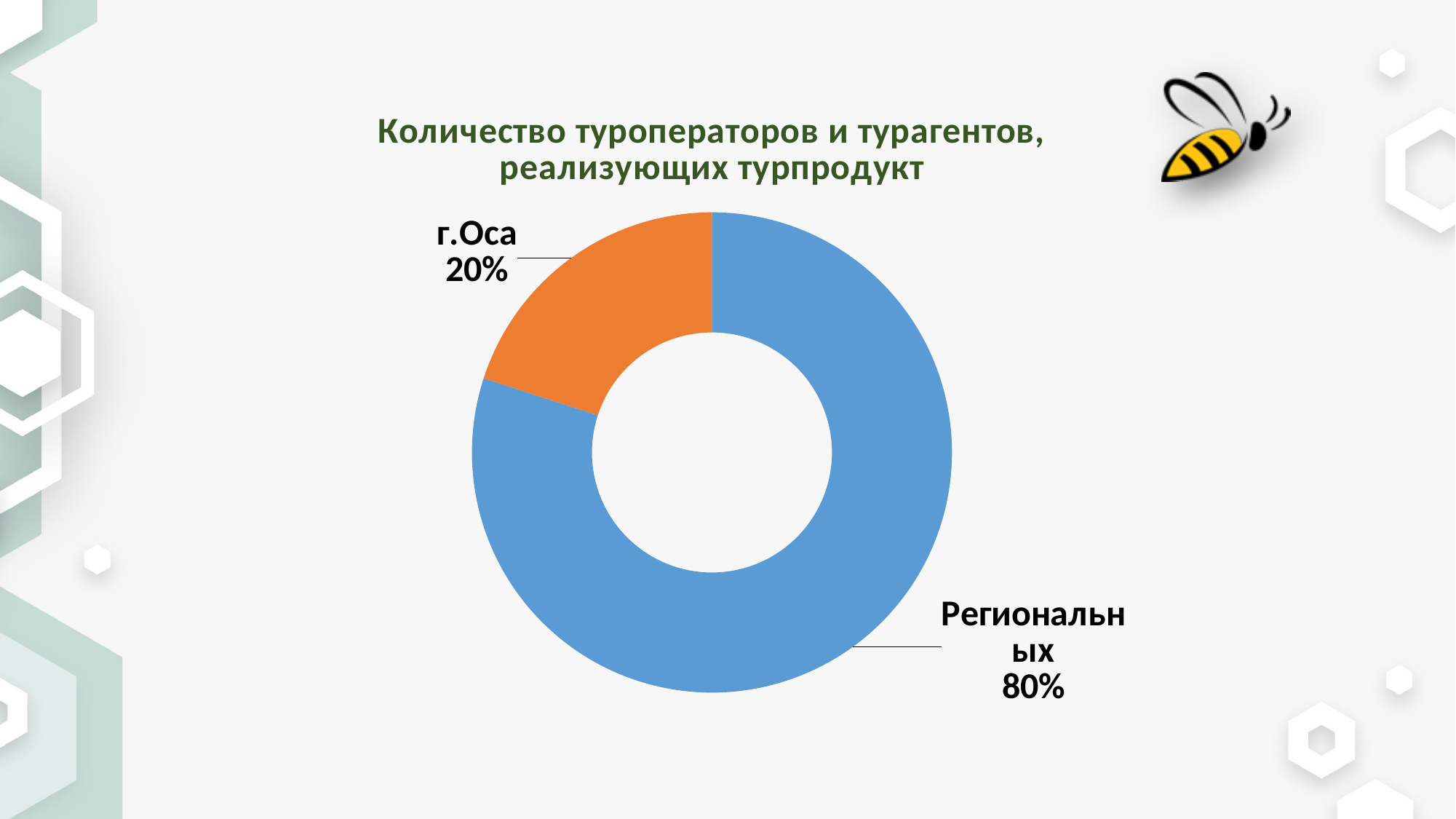
What is the title of the chart? Количество туроператоров и турагентов, реализующих турпродукт What is the difference in percentage points between the "Региональных" and "г.Оса" shares? 60 percentage points What share of the chart does the "Региональных" slice represent? 80% What colour is the "г.Оса" slice? Orange What kind of chart is shown on the slide? Doughnut (pie) chart Which category has the smallest share? г.Оса What share of the chart does the "г.Оса" slice represent? 20% How many categories are shown in the chart? 2 Which is larger, the share for "г.Оса" or the share for "Региональных"? Региональных Which category has the largest share? Региональных